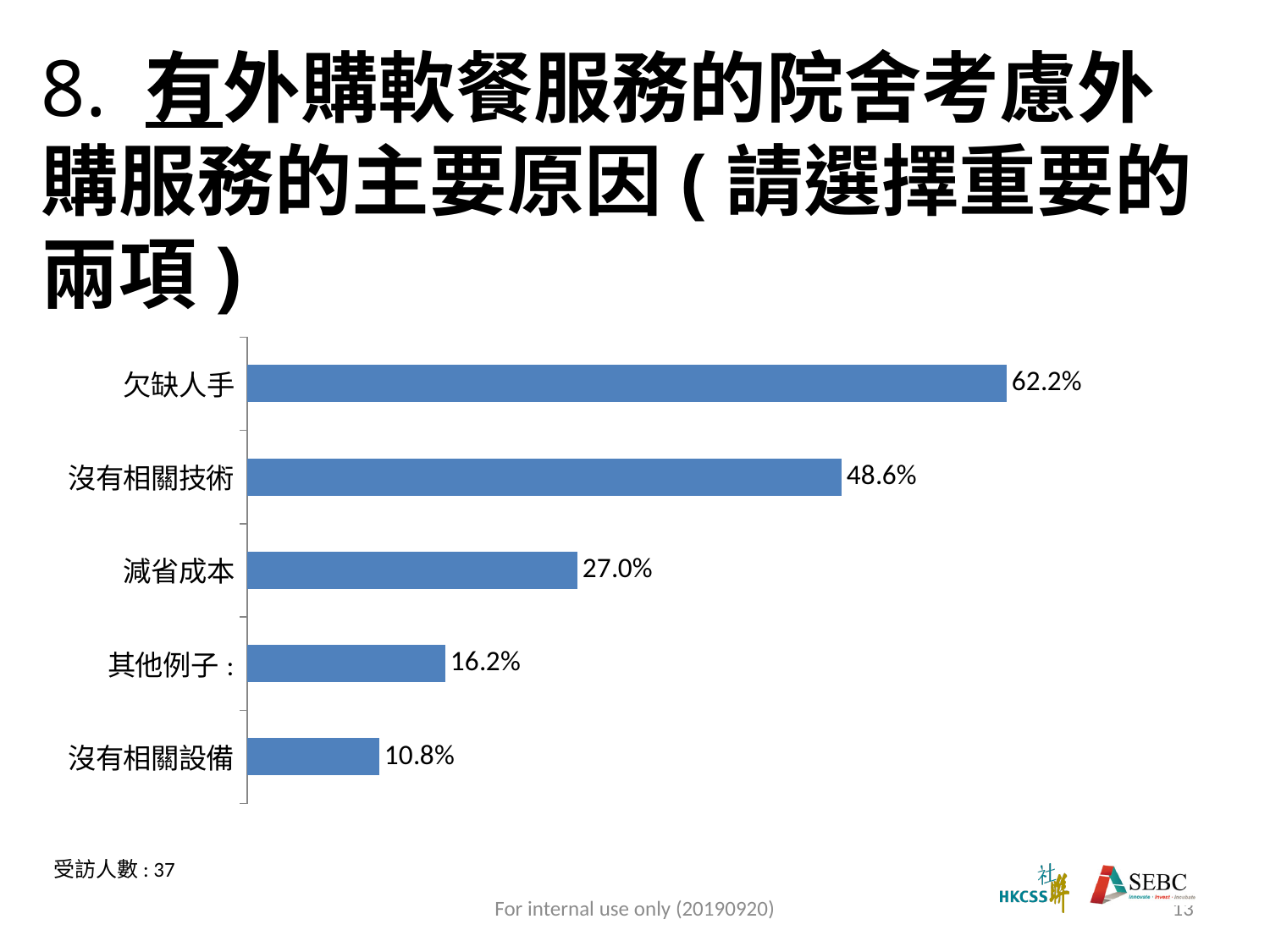
What is the value for 欠缺人手? 62.2% Which category has the lowest value? 沒有相關設備 What is the value for 沒有相關設備? 10.8% What is the number of respondents (受訪人數) stated on the slide? 37 What is the value for 減省成本? 27.0% What kind of chart is shown on the slide? Bar chart Which is larger, the value for 減省成本 or the value for 其他例子? 減省成本 What is the difference between the values for 減省成本 and 其他例子? 10.8% What is the value for 沒有相關技術? 48.6% What is the difference between the values for 欠缺人手 and 沒有相關技術? 13.6% How many categories are shown in the chart? 5 Which category has the highest value? 欠缺人手